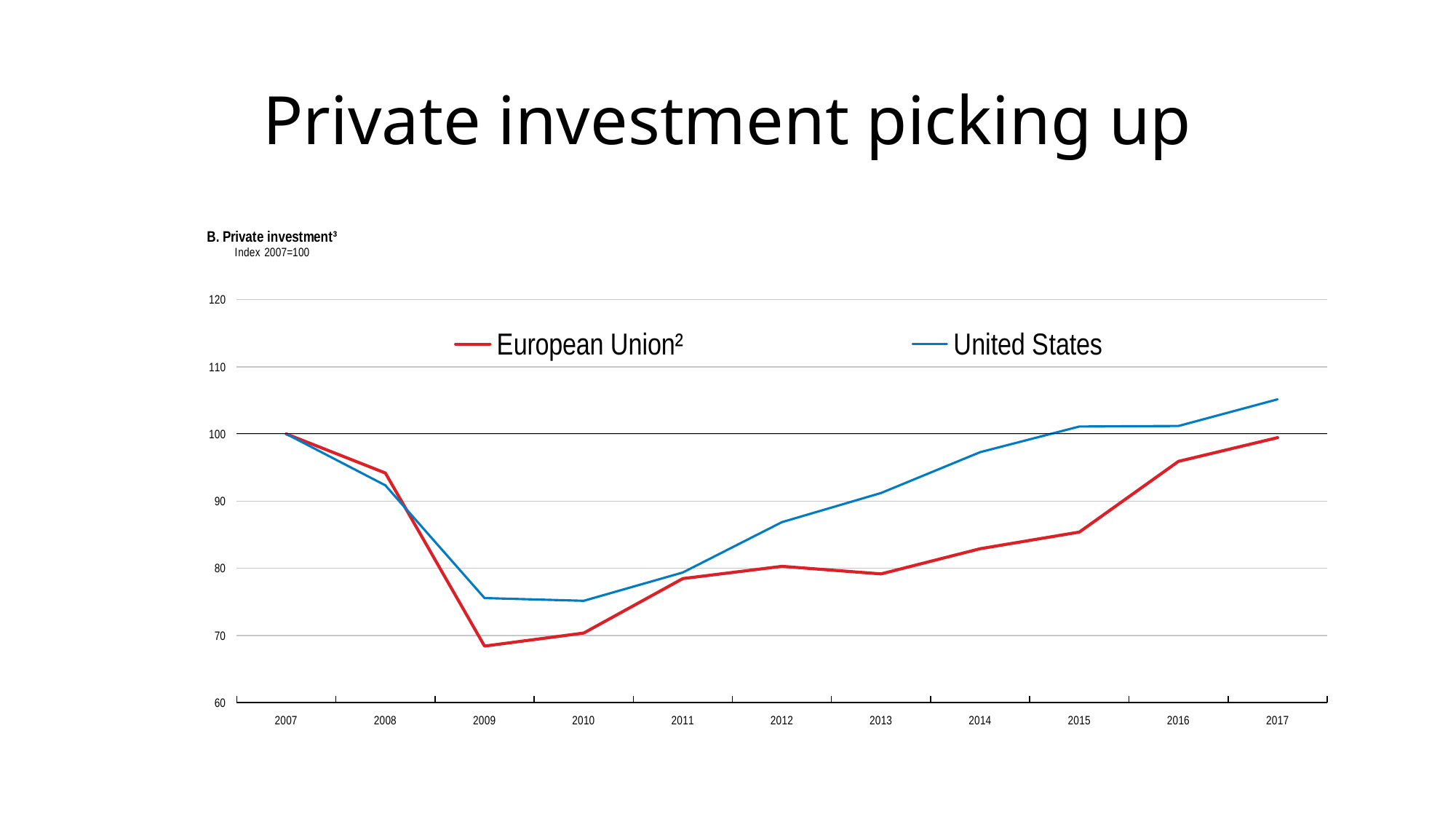
Is the value for the United States in 2014 greater or less than 100? less Which series has the higher value in 2015, the European Union or the United States? United States What colour is the line for the United States? blue Is the value for the European Union in 2009 greater or less than 70? less In which year does the United States line reach its highest value? 2017 How many series does the legend list? 2 In which year does the European Union line reach its lowest value? 2009 Is the value for the United States in 2017 greater or less than 100? greater What kind of chart is shown on the slide? line chart What is the index value for the United States in 2007? 100 Does the European Union line rise or fall from 2013 to 2017? rise How many years are plotted along the x axis? 11